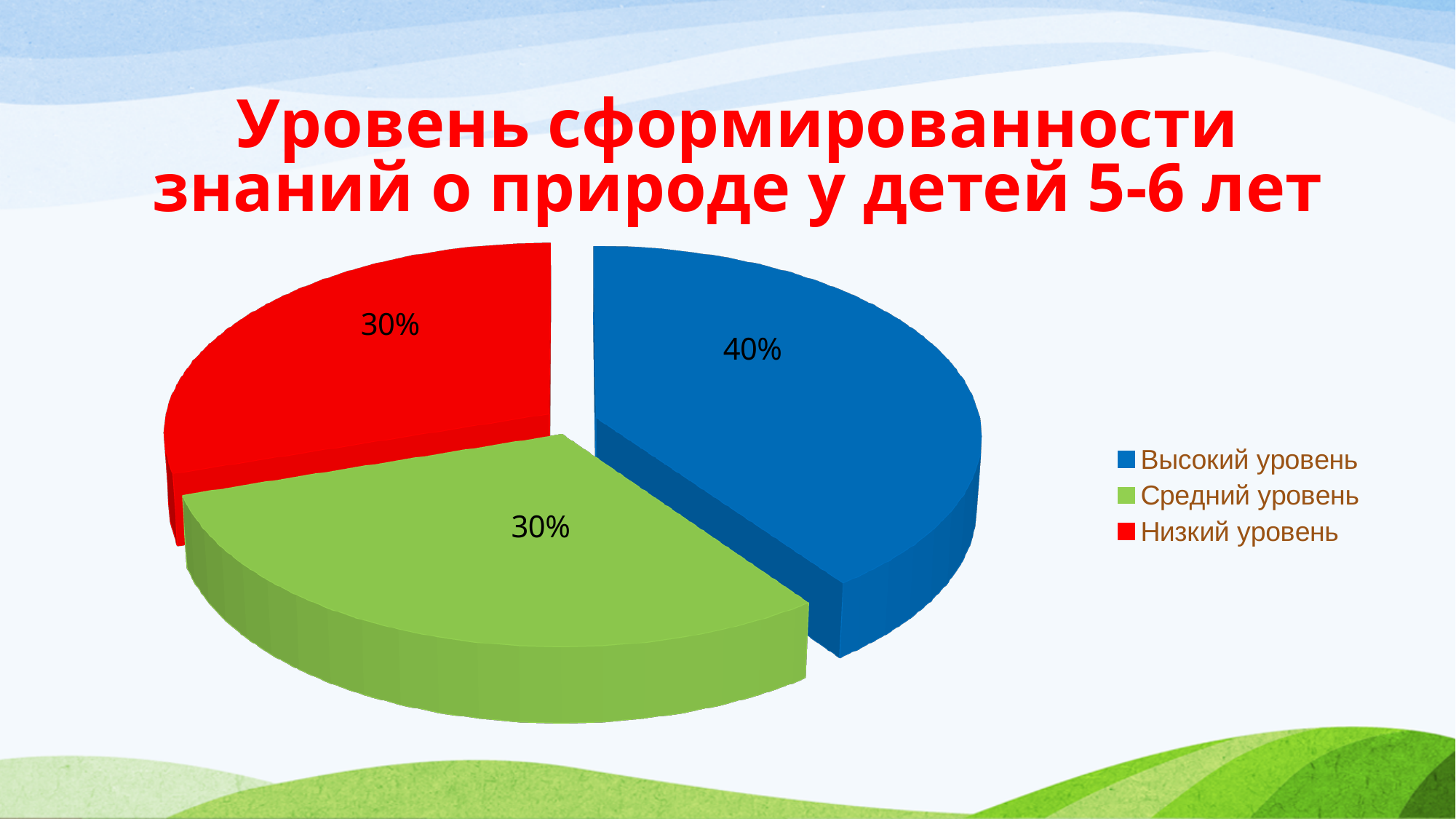
Which colour represents Низкий уровень in the chart? red What is the title of the chart on the slide? Уровень сформированности знаний о природе у детей 5-6 лет What share of the pie does Высокий уровень take? 40% How many slices does the pie chart have? 3 How many entries does the legend list? 3 What kind of chart is shown on the slide? pie chart What is the value for Средний уровень? 30% What is the value for Низкий уровень? 30% Which category has the largest share of the pie? Высокий уровень What is the value for Высокий уровень? 40% What is the difference between the values for Высокий уровень and Низкий уровень? 10% Which is larger, the value for Высокий уровень or the value for Средний уровень? Высокий уровень